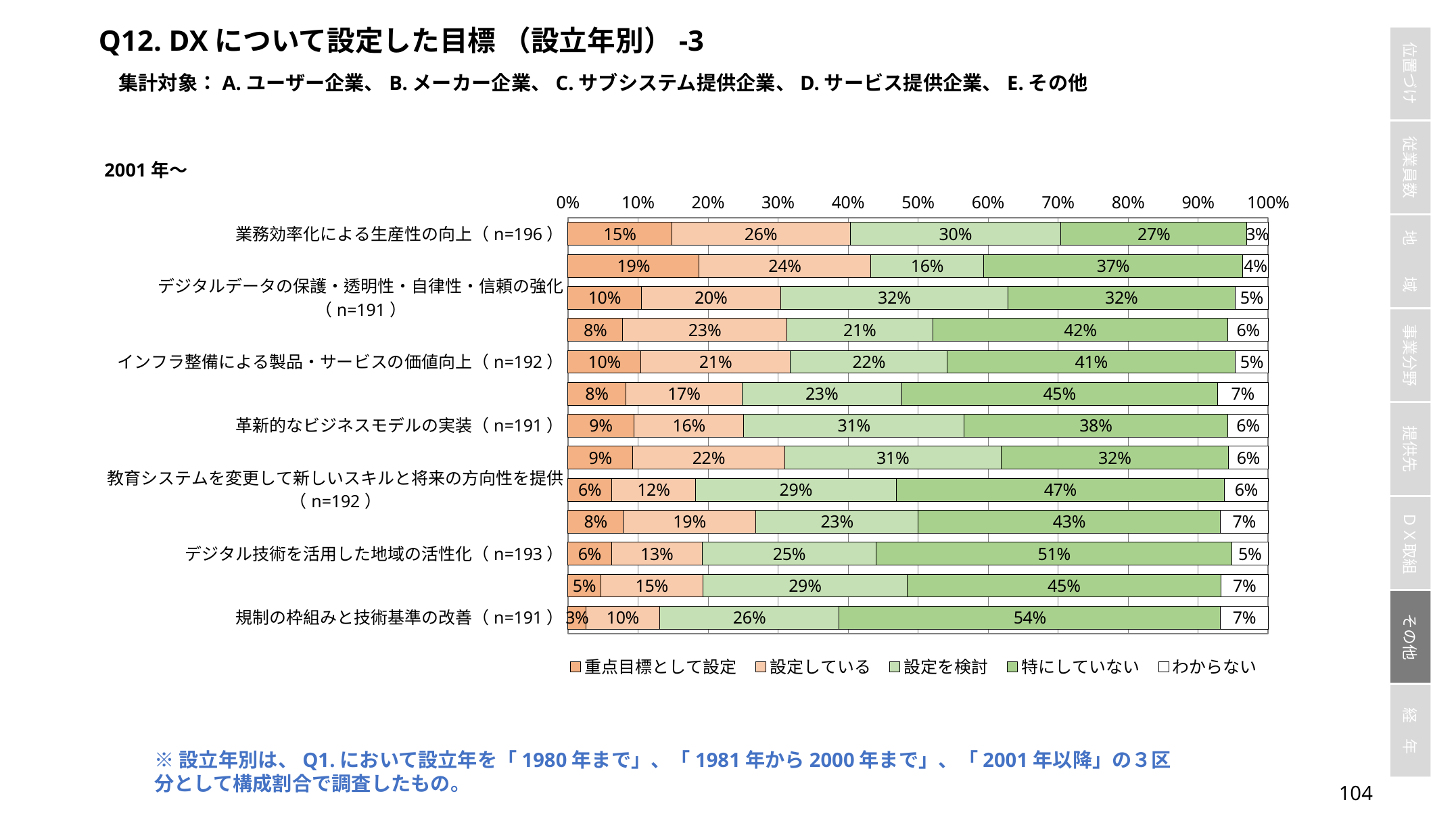
Among the labeled categories, which has the lowest 「重点目標として設定」 value? 規制の枠組みと技術基準の改善 Which is larger: the 「特にしていない」 value for インフラ整備による製品・サービスの価値向上 or for 教育システムを変更して新しいスキルと将来の方向性を提供? 教育システムを変更して新しいスキルと将来の方向性を提供 What is the 「特にしていない」 value for 規制の枠組みと技術基準の改善 (n=191)? 54% What kind of chart is shown on the slide? Horizontal stacked bar chart What is the last legend entry in the chart? わからない What is the 「設定している」 value for デジタル技術を活用した地域の活性化 (n=193)? 13% How many series does the legend list? 5 What is the 「設定を検討」 value for 革新的なビジネスモデルの実装 (n=191)? 31% What is the difference in the 「設定している」 value between 業務効率化による生産性の向上 (26%) and 規制の枠組みと技術基準の改善 (10%)? 16 percentage points How many bars are plotted in the chart? 13 Among the labeled categories, which has the highest 「特にしていない」 value? 規制の枠組みと技術基準の改善 What percentage of respondents answered 「重点目標として設定」 for 業務効率化による生産性の向上 (n=196)? 15%